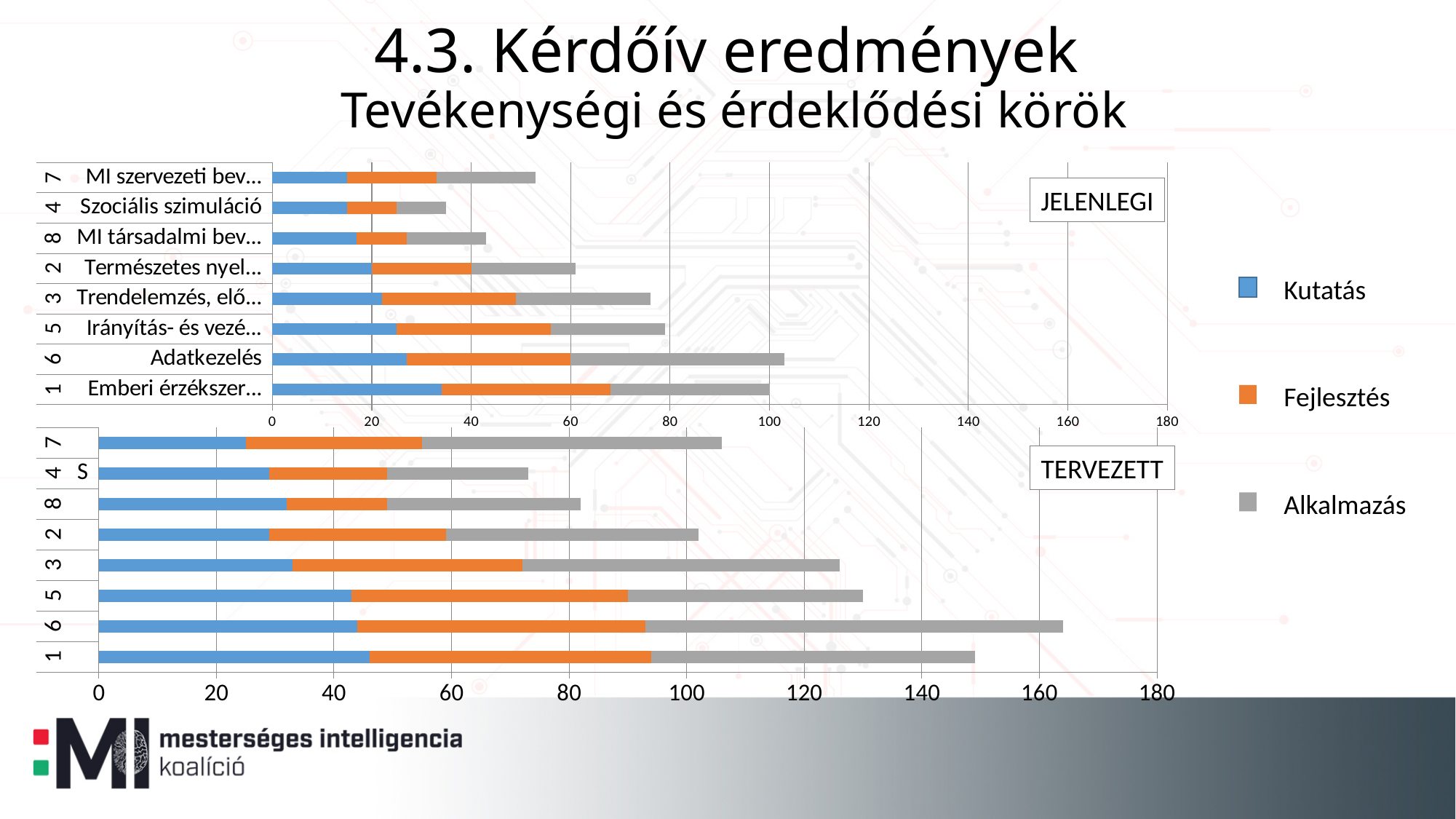
In the JELENLEGI chart, is the total bar for Trendelemzés, elő... greater or less than 60? greater What kind of chart is the JELENLEGI chart? Stacked bar chart How many categories are shown in the JELENLEGI chart? 8 In the JELENLEGI chart, which category has the shortest total bar? Szociális szimuláció In the JELENLEGI chart, which has the longer total bar: Adatkezelés or Szociális szimuláció? Adatkezelés In the JELENLEGI chart, is the total bar for Szociális szimuláció greater or less than 40? less In the TERVEZETT chart, which category has the longest total bar? 6 Which colour represents Fejlesztés in the charts? Orange In the TERVEZETT chart, is the total bar for category 1 greater or less than 140? greater What are the three series named in the legend? Kutatás, Fejlesztés, Alkalmazás How many series does the legend list? 3